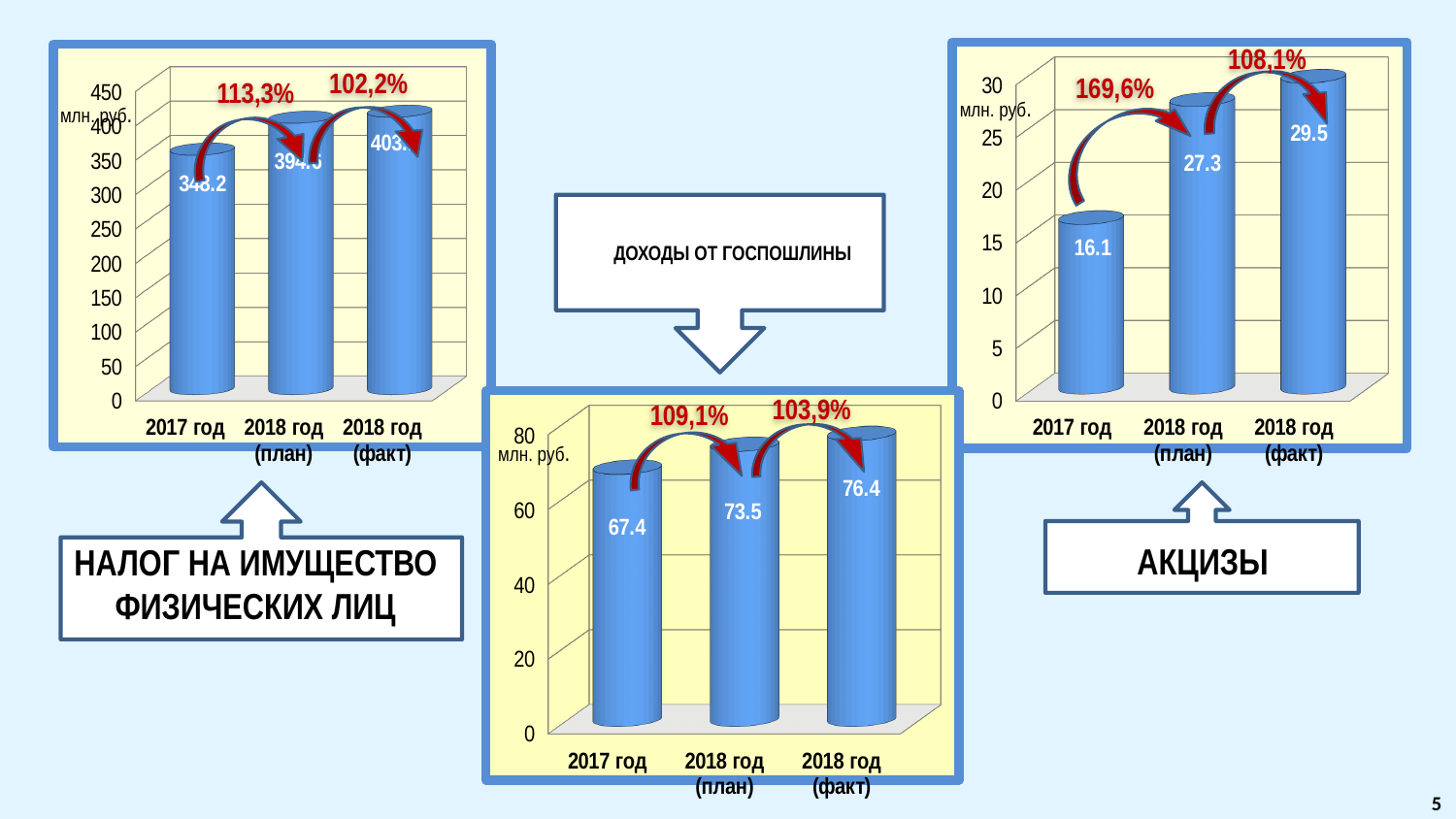
In the chart labelled АКЦИЗЫ (right), what is the value for 2018 год (план)? 27.3 In the chart labelled НАЛОГ НА ИМУЩЕСТВО ФИЗИЧЕСКИХ ЛИЦ (left), which category has the lowest value? 2017 год What kind of chart is the chart labelled АКЦИЗЫ (right)? bar chart In the chart labelled НАЛОГ НА ИМУЩЕСТВО ФИЗИЧЕСКИХ ЛИЦ (left), what is the value for 2017 год? 348.2 In the chart labelled АКЦИЗЫ (right), which category has the highest value? 2018 год (факт) In the chart labelled ДОХОДЫ ОТ ГОСПОШЛИНЫ (middle), what is the difference between the 2018 год (факт) and 2017 год values? 9 In the chart labelled АКЦИЗЫ (right), what is the value for 2017 год? 16.1 In the chart labelled НАЛОГ НА ИМУЩЕСТВО ФИЗИЧЕСКИХ ЛИЦ (left), is the value for 2018 год (факт) greater or less than 400? greater In the chart labelled АКЦИЗЫ (right), what is the difference between the 2018 год (план) and 2017 год values? 11.2 In the chart labelled ДОХОДЫ ОТ ГОСПОШЛИНЫ (middle), do the values rise or fall from 2017 год to 2018 год (факт)? rise In the chart labelled ДОХОДЫ ОТ ГОСПОШЛИНЫ (middle), what is the value for 2017 год? 67.4 In the chart labelled ДОХОДЫ ОТ ГОСПОШЛИНЫ (middle), what is the value for 2018 год (факт)? 76.4